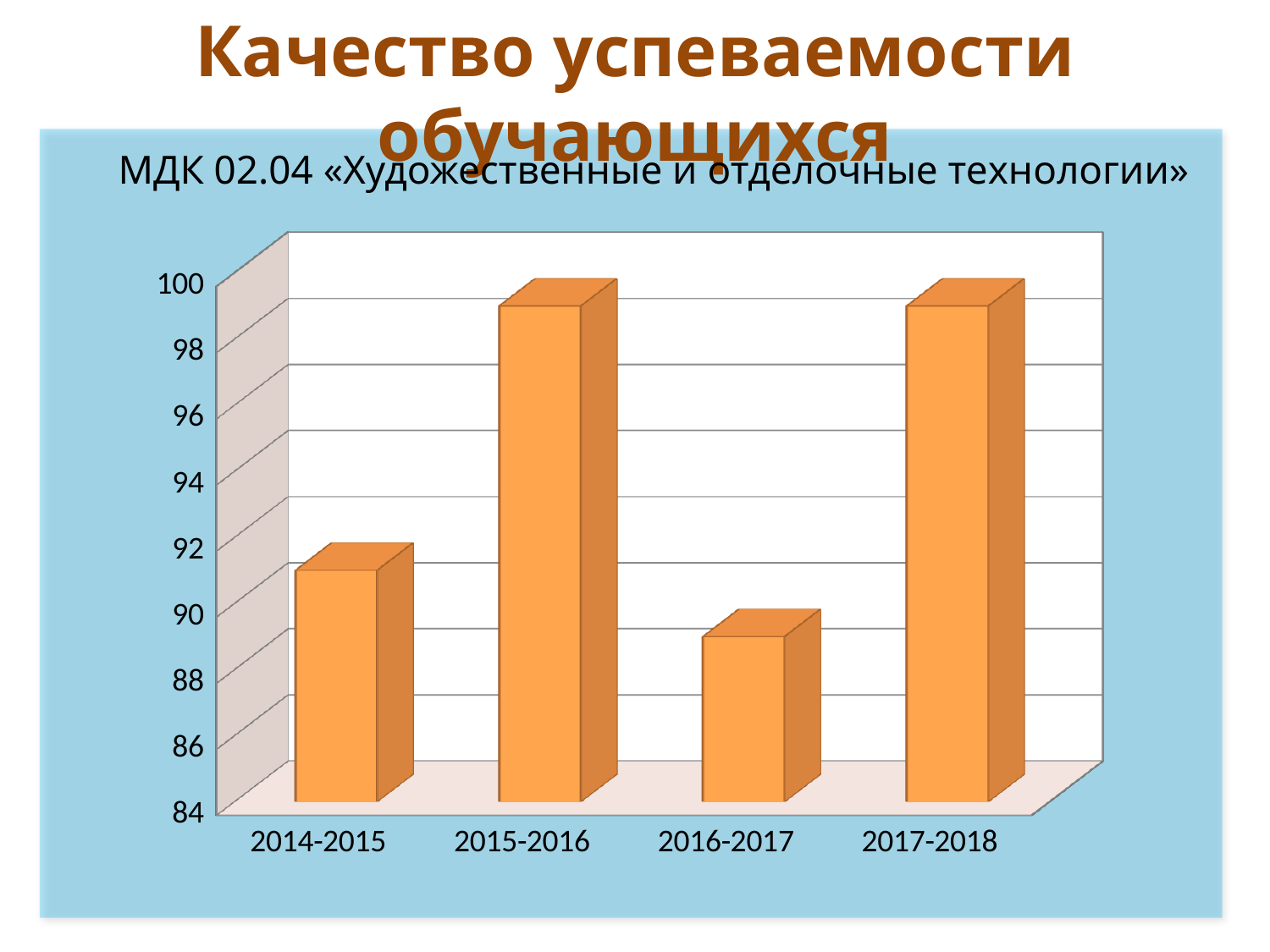
Is the value for 2014-2015 greater or less than 92? less What is the title shown above the chart? МДК 02.04 «Художественные и отделочные технологии» Which is larger, the value for 2014-2015 or the value for 2016-2017? 2014-2015 Is the value for 2015-2016 greater or less than 98? greater Is the value for 2017-2018 greater or less than 96? greater Which is larger, the value for 2015-2016 or the value for 2016-2017? 2015-2016 How many academic years (categories) are shown on the x axis of the chart? 4 Does the value rise or fall from 2015-2016 to 2016-2017? fall What kind of chart is shown on the slide? bar chart Which academic year has the lowest value in the chart? 2016-2017